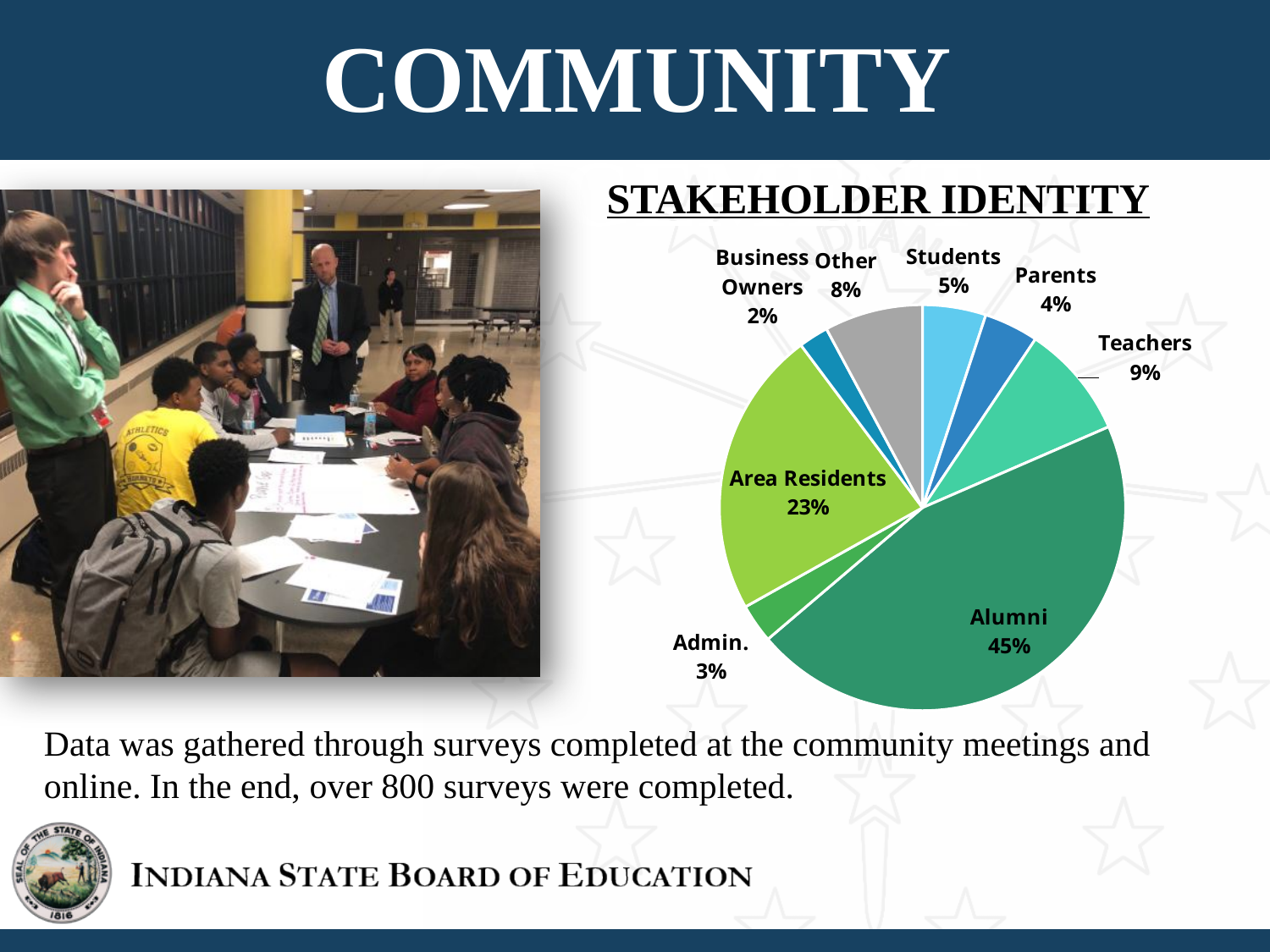
What is the combined share of Teachers and Other? 17% Which is larger, the share for Students or the share for Parents? Students Which category has the largest slice of the pie chart? Alumni How many categories are shown in the pie chart? 8 Which category has the smallest slice of the pie chart? Business Owners What percentage is shown for Business Owners? 2% What percentage of stakeholders are Area Residents? 23% What share of the pie chart is Alumni? 45% What percentage is shown for Teachers? 9% What is the difference in percentage points between Alumni and Area Residents? 22 What is the title of the pie chart? STAKEHOLDER IDENTITY What type of chart is shown under the title STAKEHOLDER IDENTITY? Pie chart